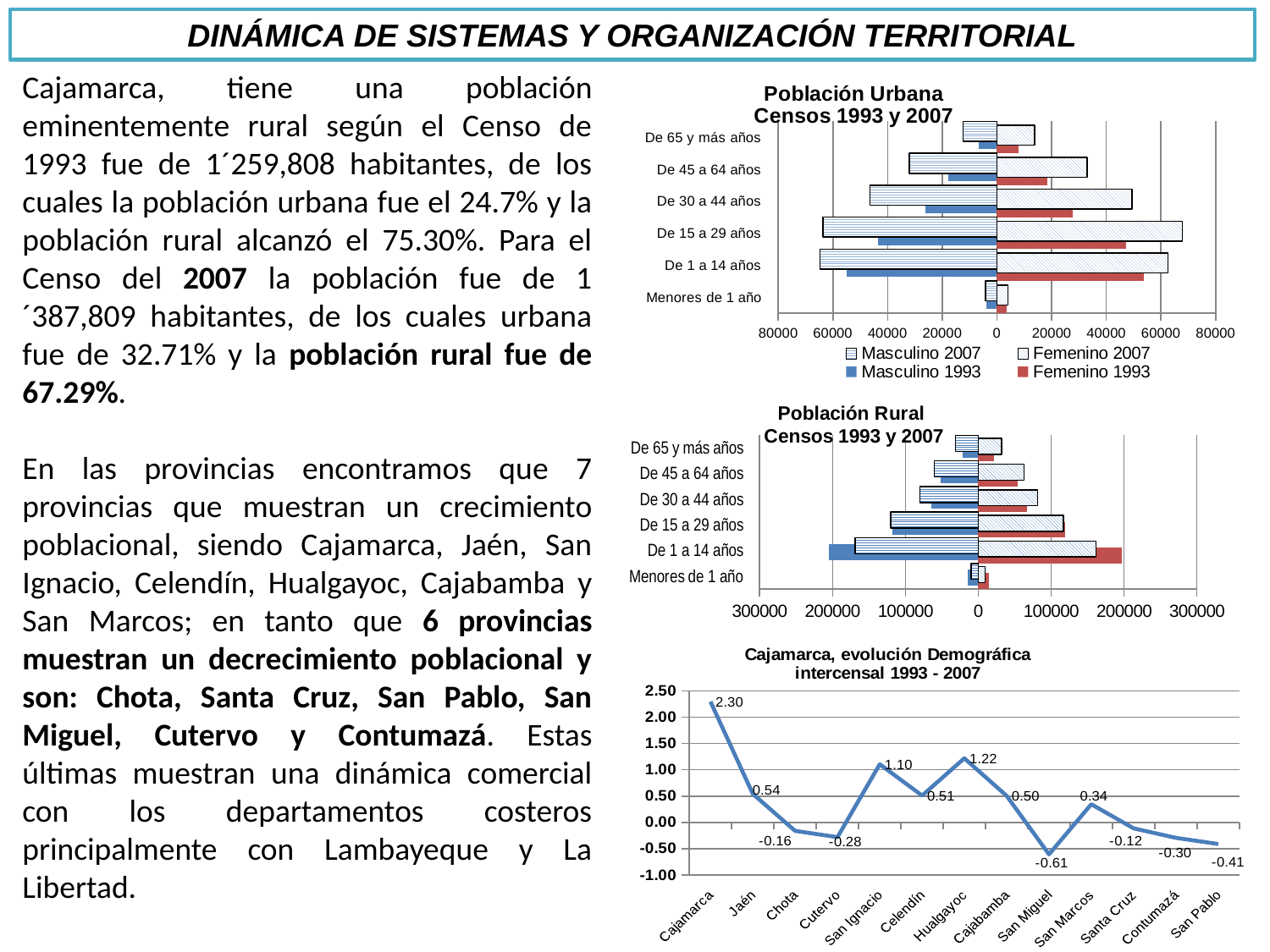
How many series does the legend of the chart 'Población Urbana Censos 1993 y 2007' list? 4 In the chart 'Cajamarca, evolución Demográfica intercensal 1993 - 2007', what is the value for Cajamarca? 2.30 In the chart 'Población Urbana Censos 1993 y 2007', is the Femenino 2007 value for 'De 15 a 29 años' greater or less than 60000? greater How many age groups are shown in the chart 'Población Rural Censos 1993 y 2007'? 6 In the chart 'Cajamarca, evolución Demográfica intercensal 1993 - 2007', which province has the highest value? Cajamarca What kind of chart is 'Cajamarca, evolución Demográfica intercensal 1993 - 2007'? Line chart In the chart 'Cajamarca, evolución Demográfica intercensal 1993 - 2007', what is the difference between the values for Cajamarca and Jaén? 1.76 In the chart 'Cajamarca, evolución Demográfica intercensal 1993 - 2007', which province has the lowest value? San Miguel What kind of chart is 'Población Urbana Censos 1993 y 2007'? Bar chart How many provinces are plotted in the chart 'Cajamarca, evolución Demográfica intercensal 1993 - 2007'? 13 In the chart 'Cajamarca, evolución Demográfica intercensal 1993 - 2007', what is the value for Hualgayoc? 1.22 In the chart 'Cajamarca, evolución Demográfica intercensal 1993 - 2007', which has the larger value, San Ignacio or Hualgayoc? Hualgayoc